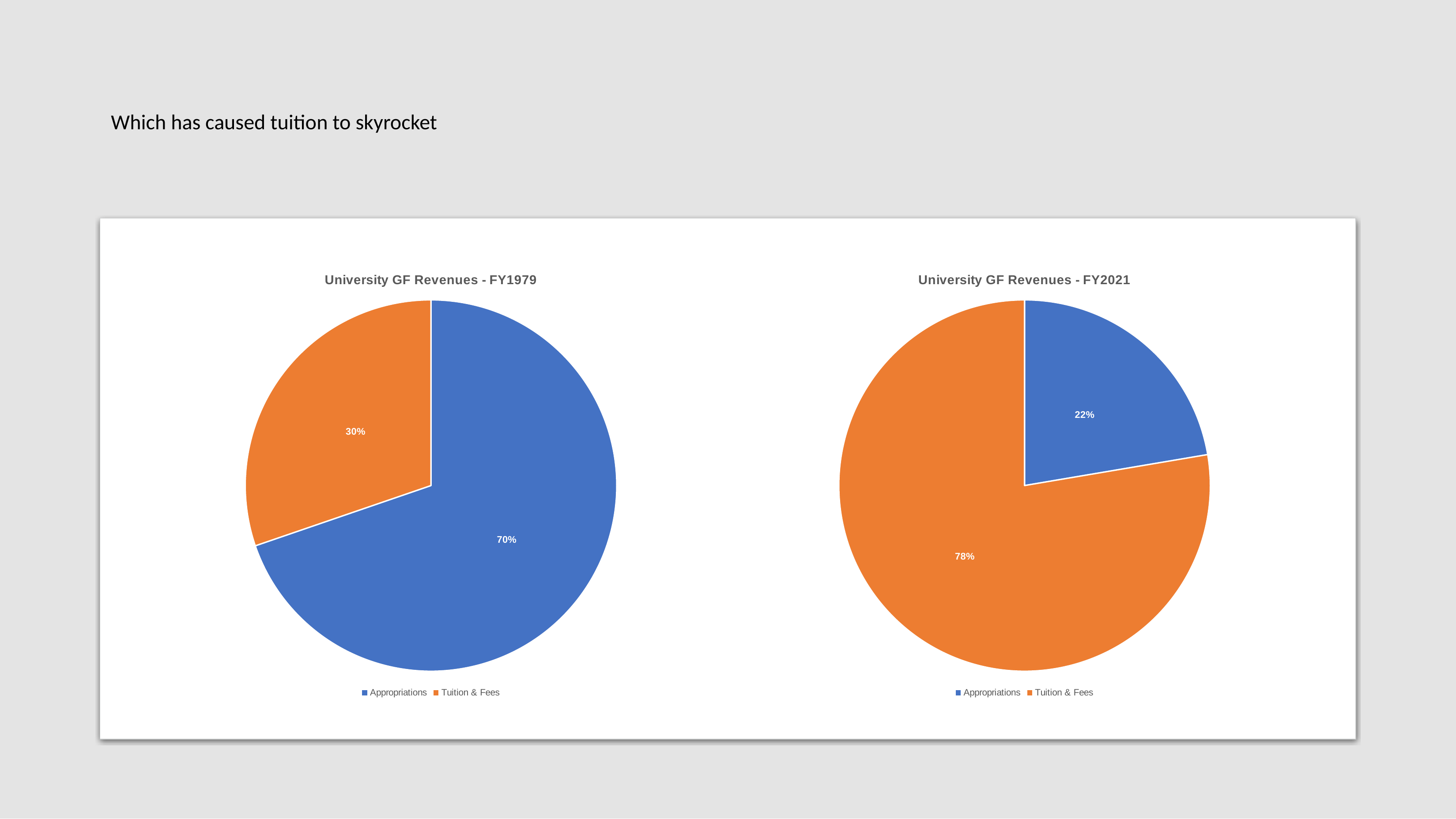
In the 'University GF Revenues - FY1979' chart, what is the difference between the Appropriations share and the Tuition & Fees share? 40% In the 'University GF Revenues - FY1979' chart, which category has the largest slice? Appropriations In the 'University GF Revenues - FY2021' chart, what share does Tuition & Fees have? 78% In the 'University GF Revenues - FY1979' chart, what share does Tuition & Fees have? 30% Is the Appropriations share larger in the 'University GF Revenues - FY1979' chart or in the 'University GF Revenues - FY2021' chart? FY1979 How many slices does the 'University GF Revenues - FY2021' chart have? 2 In the 'University GF Revenues - FY2021' chart, what colour is the Tuition & Fees slice? Orange What kind of chart is 'University GF Revenues - FY1979'? Pie chart In the 'University GF Revenues - FY2021' chart, what is the difference between the Tuition & Fees share and the Appropriations share? 56% In the 'University GF Revenues - FY2021' chart, what share does Appropriations have? 22% In the 'University GF Revenues - FY2021' chart, which category has the smallest slice? Appropriations In the 'University GF Revenues - FY1979' chart, what share does Appropriations have? 70%